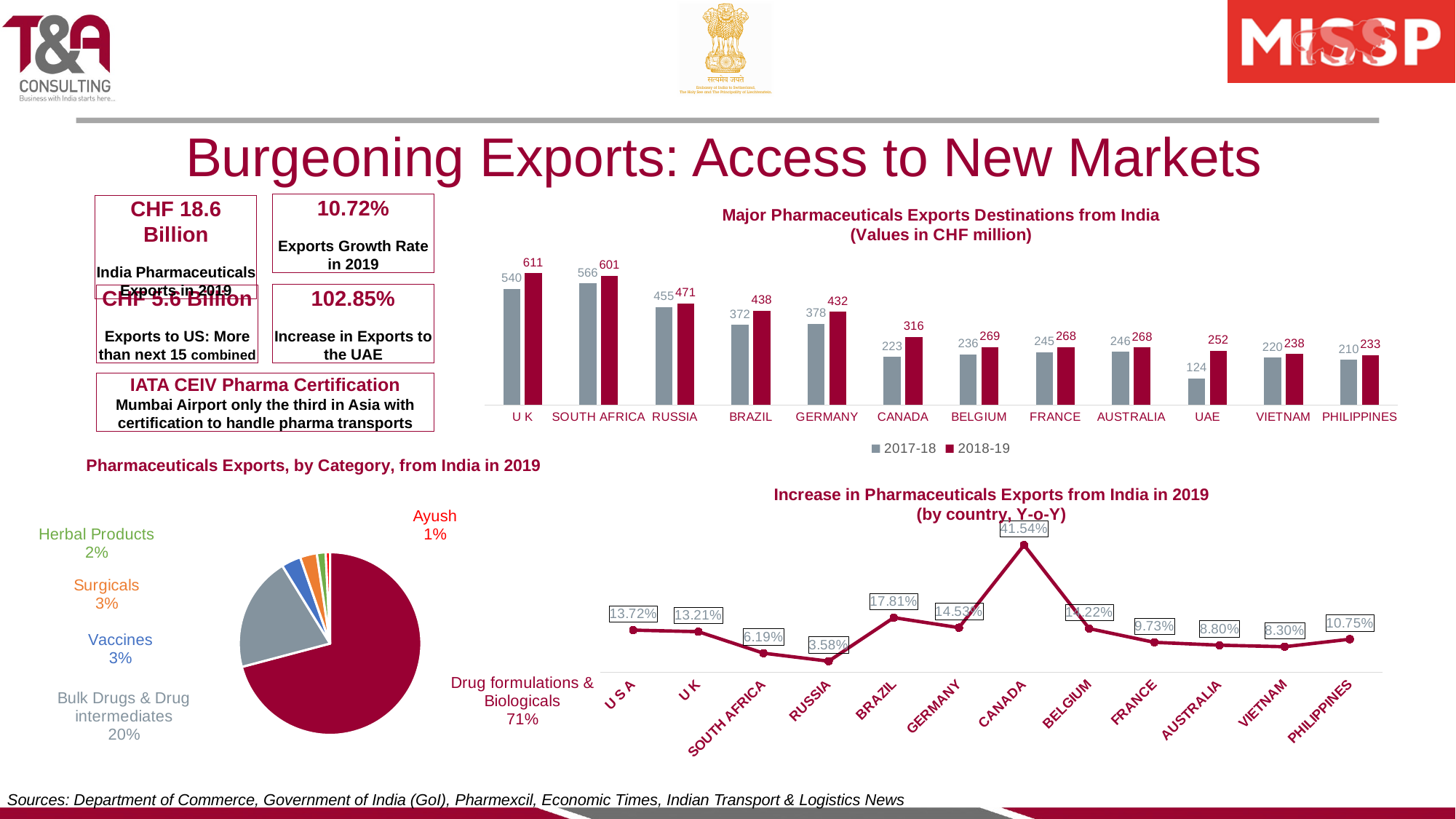
In the 'Increase in Pharmaceuticals Exports from India in 2019 (by country, Y-o-Y)' chart, what is the value for Russia? 3.58% In the 'Major Pharmaceuticals Exports Destinations from India' bar chart, what is the 2018-19 value for the UK? 611 In the 'Increase in Pharmaceuticals Exports from India in 2019 (by country, Y-o-Y)' chart, which is larger, the value for USA or the value for Brazil? Brazil In the 'Pharmaceuticals Exports, by Category, from India in 2019' pie chart, which category has the smallest share? Ayush In the 'Pharmaceuticals Exports, by Category, from India in 2019' chart, what share does Drug formulations & Biologicals have? 71% In the 'Major Pharmaceuticals Exports Destinations from India' bar chart, what is the 2017-18 value for the UAE? 124 In the 'Major Pharmaceuticals Exports Destinations from India' bar chart, what is the difference between the 2018-19 and 2017-18 values for Canada? 93 In the 'Major Pharmaceuticals Exports Destinations from India' bar chart, which country has the highest 2018-19 value? U K In the 'Major Pharmaceuticals Exports Destinations from India' bar chart, how many series does the legend list? 2 In the 'Major Pharmaceuticals Exports Destinations from India' bar chart, how many countries are shown? 12 In the 'Increase in Pharmaceuticals Exports from India in 2019 (by country, Y-o-Y)' chart, which country has the highest value? CANADA What kind of chart is 'Pharmaceuticals Exports, by Category, from India in 2019'? Pie chart